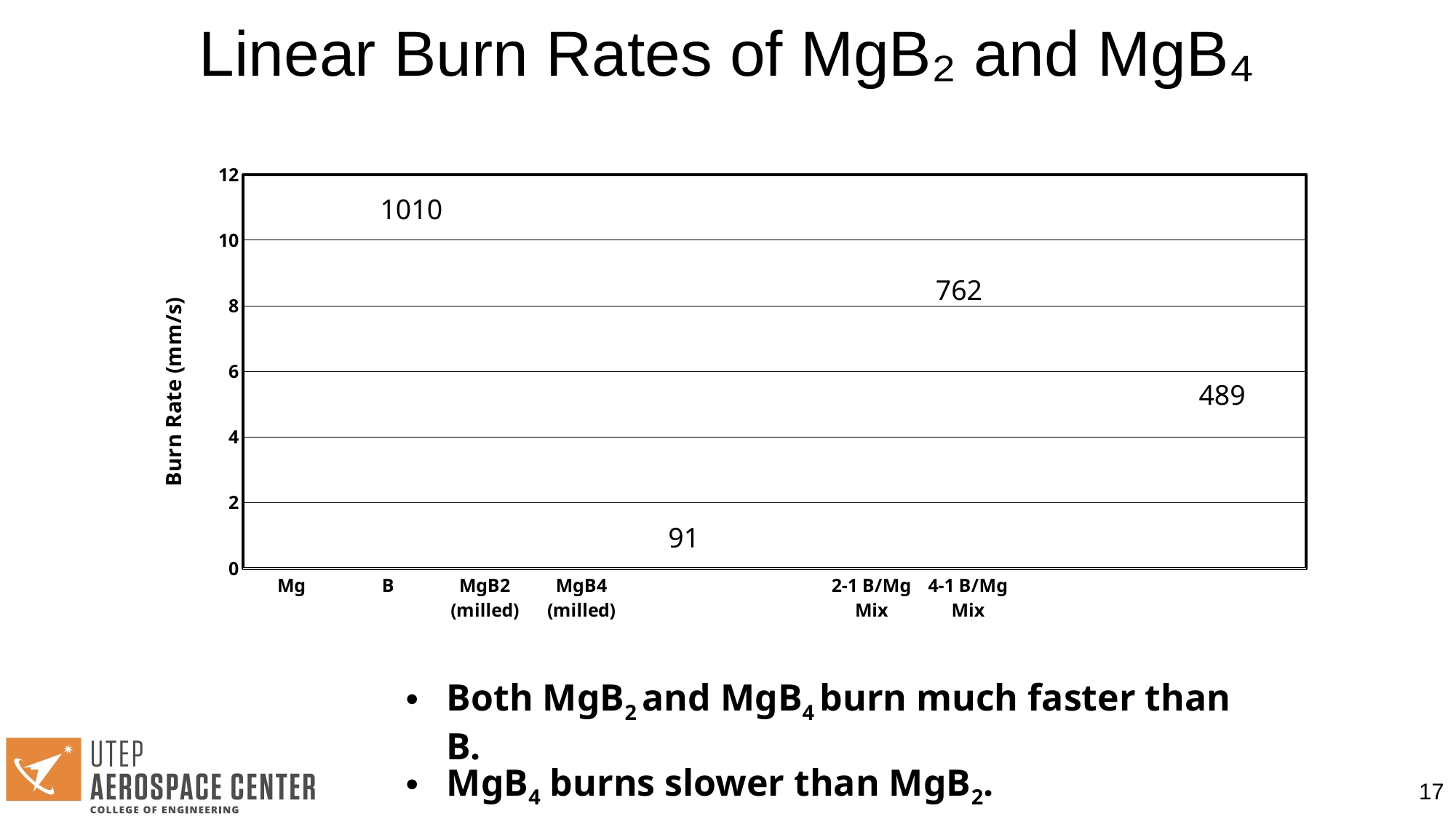
What is the title of the chart's vertical axis? Burn Rate (mm/s) What is the smallest data label value printed on the chart? 91 How many category labels are shown along the x axis of the chart? 6 What is the largest data label value printed on the chart? 1010 Which printed data label is larger on the chart, 762 or 489? 762 What is the highest tick value shown on the chart's vertical axis? 12 What is the label of the first category on the chart's x axis? Mg How many data labels are printed inside the chart's plot area? 4 What is the difference between the largest and smallest data label values printed on the chart (1010 and 91)? 919 What is the difference between the data labels 762 and 489 printed on the chart? 273